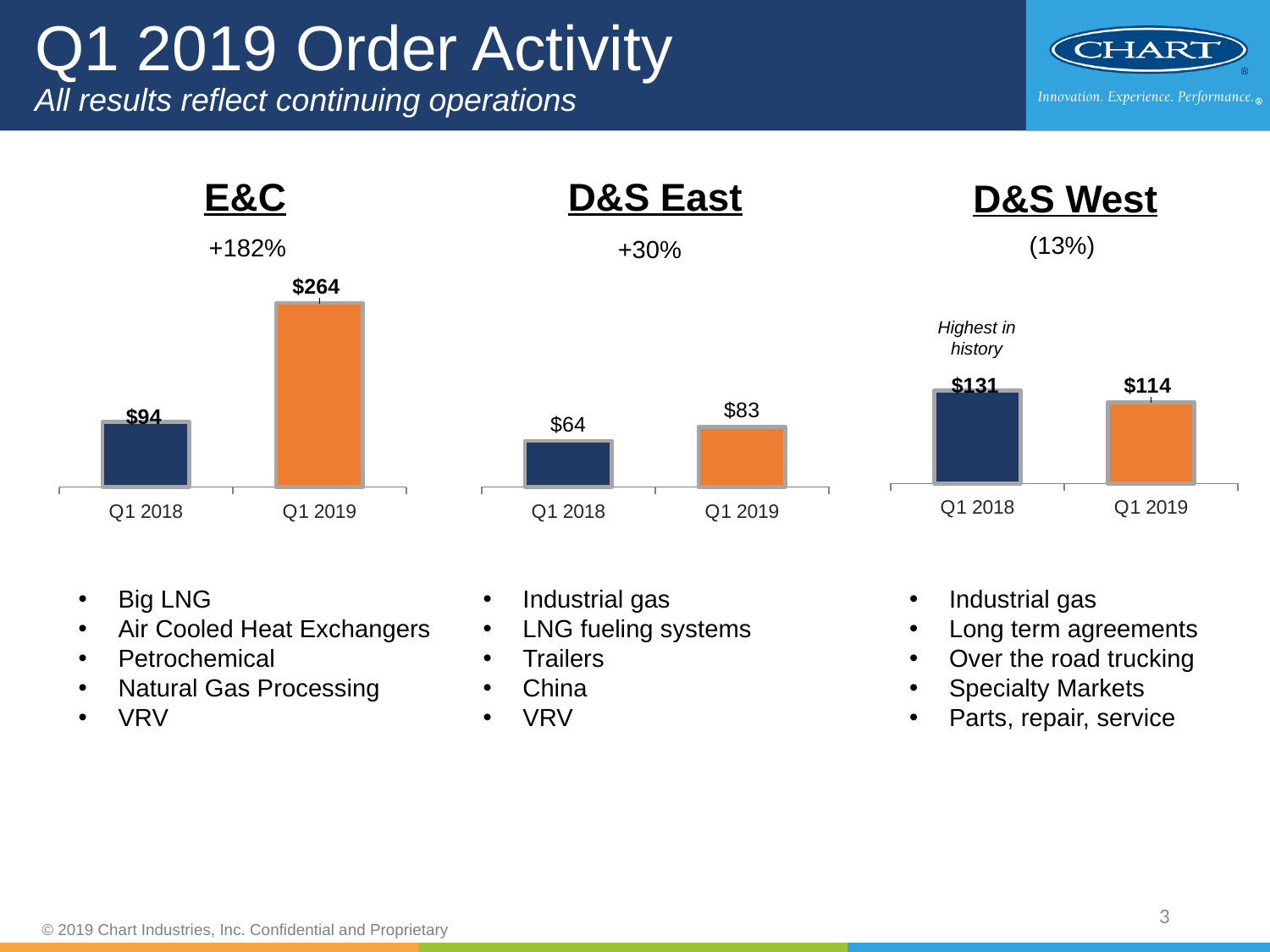
In the E&C chart, what is the difference between the Q1 2019 and Q1 2018 values? $170 What kind of chart is the D&S East chart? Bar chart In the D&S West chart, which period has the higher value, Q1 2018 or Q1 2019? Q1 2018 In the D&S West chart, what is the value for Q1 2019? $114 In the D&S East chart, what is the value for Q1 2019? $83 In the E&C chart, what is the value for Q1 2018? $94 In the D&S East chart, what is the value for Q1 2018? $64 How many bars are shown in the D&S West chart? 2 In the D&S East chart, do values rise or fall from Q1 2018 to Q1 2019? Rise In the D&S West chart, what is the value for Q1 2018? $131 What percentage change is shown above the E&C chart? +182% In the E&C chart, what is the value for Q1 2019? $264